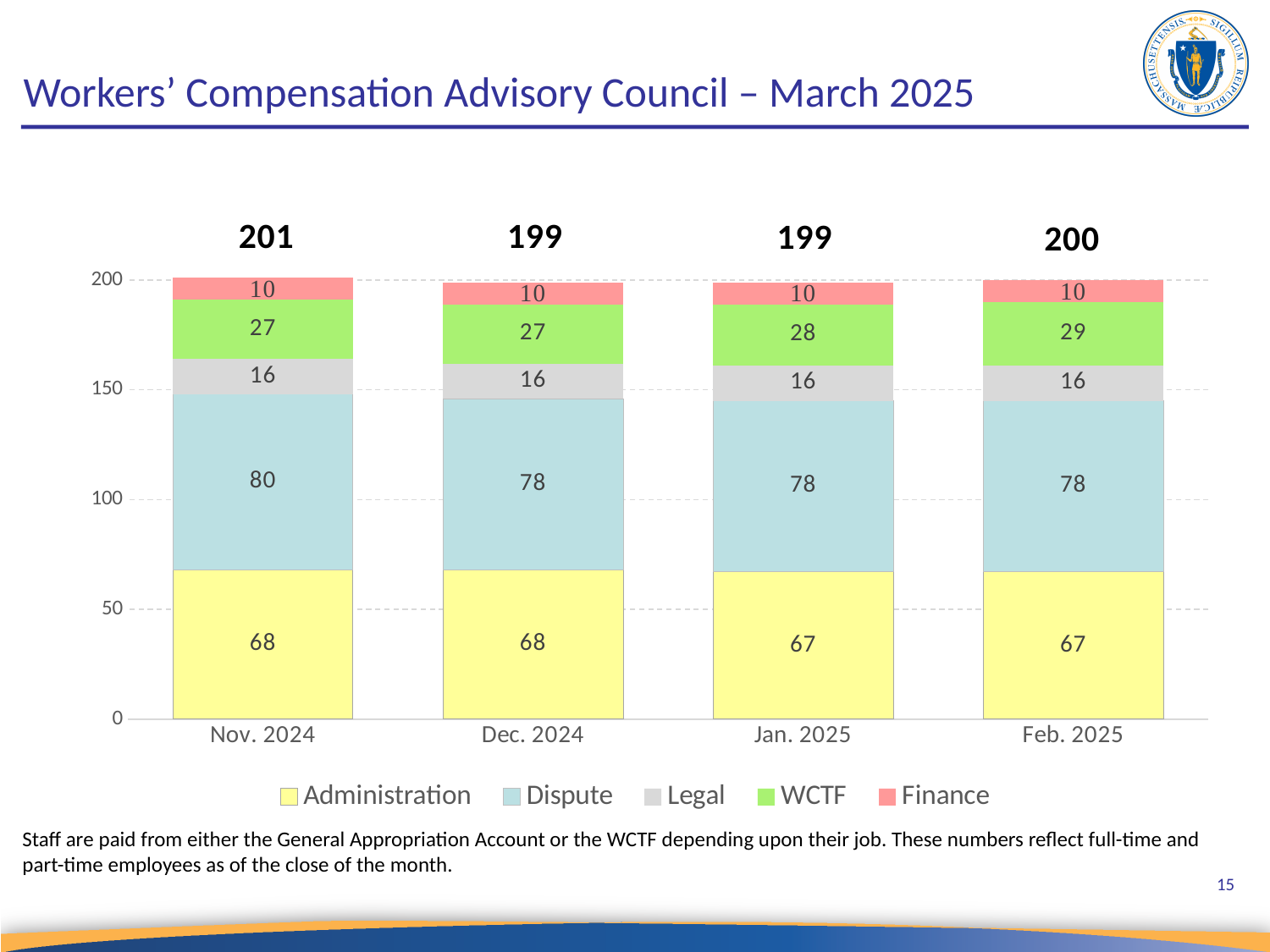
What is the difference between the Dispute values for Nov. 2024 and Dec. 2024? 2 What is the total of the stacked bar for Nov. 2024? 201 What is the total of the stacked bar for Feb. 2025? 200 What is the WCTF value for Feb. 2025? 29 Which month has the highest total staff count? Nov. 2024 How many series does the legend list? 5 What is the Dispute value for Nov. 2024? 80 What kind of chart is shown on the slide? Stacked bar chart How many months are shown on the x axis? 4 Which series is shown in yellow in the legend? Administration Which is larger, the WCTF value for Jan. 2025 or the WCTF value for Feb. 2025? Feb. 2025 What is the Administration value for Jan. 2025? 67